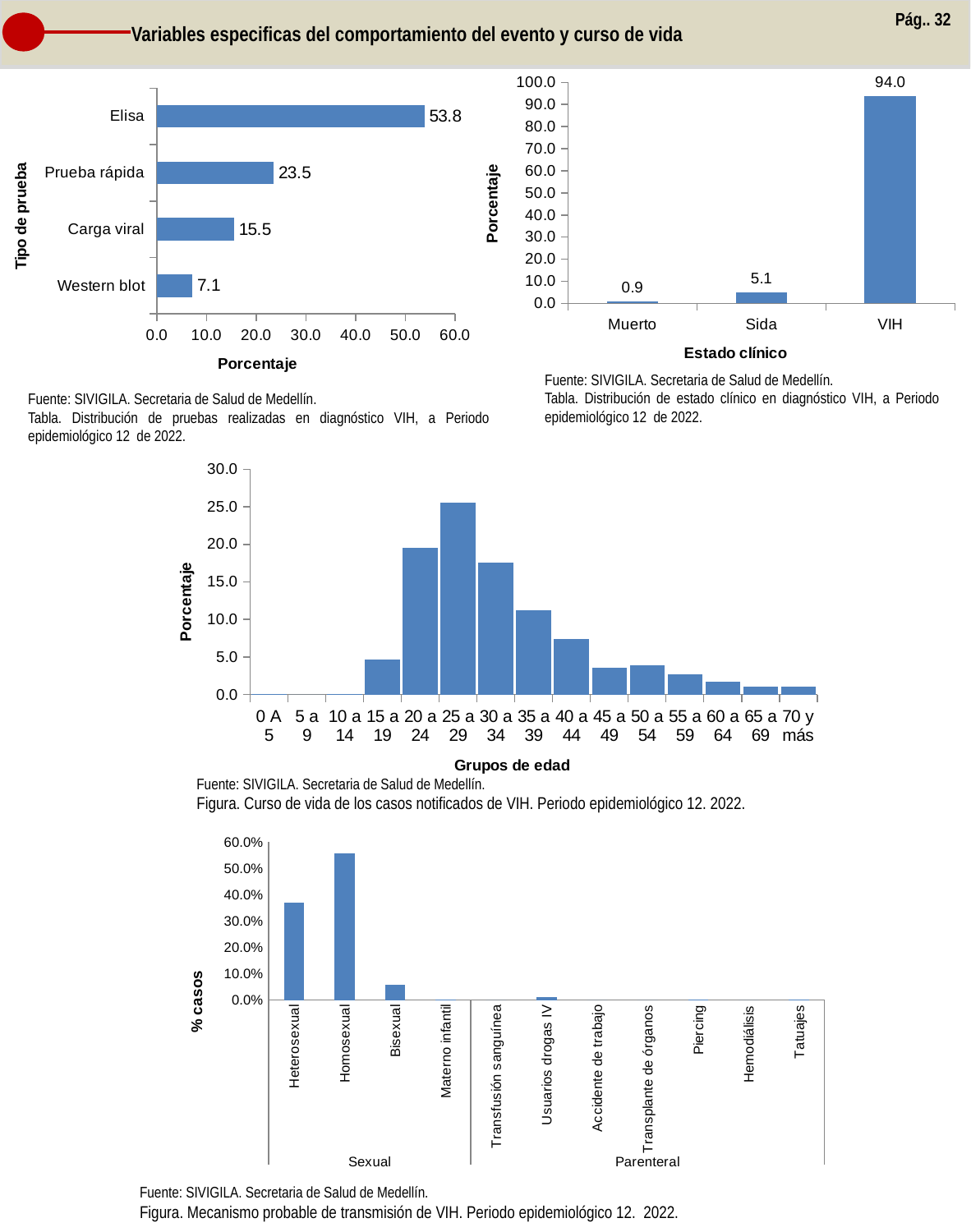
In the top-left chart (Tipo de prueba), what is the difference between Prueba rápida and Carga viral? 8.0 In the middle chart (Grupos de edad), which age group has the highest percentage? 25 a 29 In the top-right chart (Estado clínico), what is the value for VIH? 94.0 In the bottom chart (Mecanismo probable de transmisión), which category has the highest percentage of cases? Homosexual In the middle chart (Grupos de edad), is the value for 30 a 34 greater or less than 15.0? greater In the top-left chart (Tipo de prueba), what is the value for Elisa? 53.8 In the top-left chart (Tipo de prueba), what is the value for Western blot? 7.1 In the top-right chart (Estado clínico), which category has the lowest value? Muerto In the middle chart (Grupos de edad), how many age groups are shown on the x axis? 15 In the top-right chart (Estado clínico), what is the difference between Sida and Muerto? 4.2 In the bottom chart (Mecanismo probable de transmisión), is the value for Heterosexual greater or less than 30.0%? greater In the top-left chart (Tipo de prueba), how many test types are shown? 4